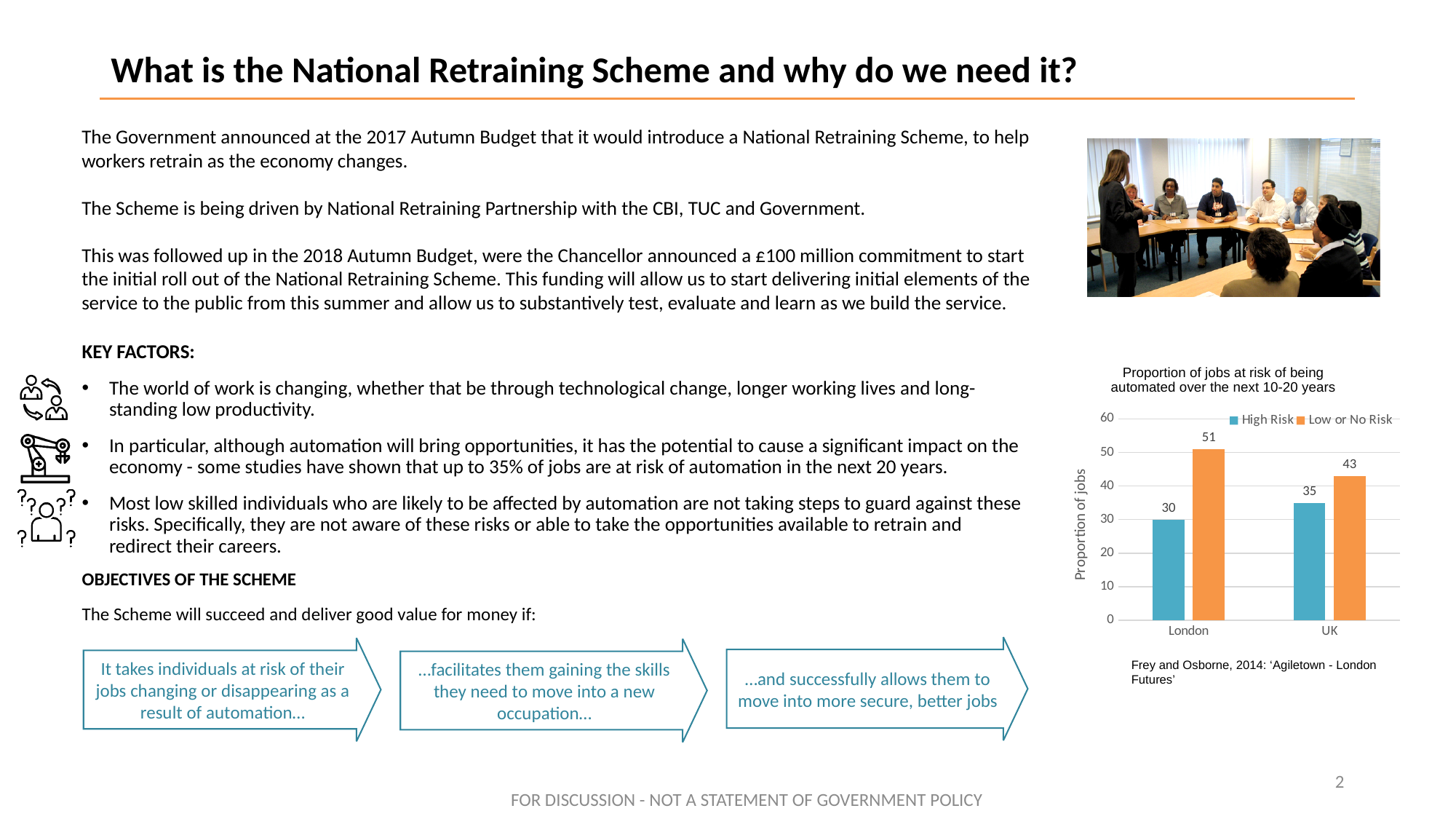
What kind of chart is shown on the slide? Bar chart Which category has the highest Low or No Risk value? London What is the Low or No Risk value for the UK? 43 Is the High Risk value for the UK larger than the High Risk value for London? Yes What is the High Risk value for the UK? 35 What is the title of the chart? Proportion of jobs at risk of being automated over the next 10-20 years How many series does the chart legend list? 2 What is the High Risk value for London? 30 Which category has the lowest High Risk value? London How many categories are shown on the x axis of the chart? 2 What is the difference between the Low or No Risk and High Risk values for London? 21 What is the Low or No Risk value for London? 51